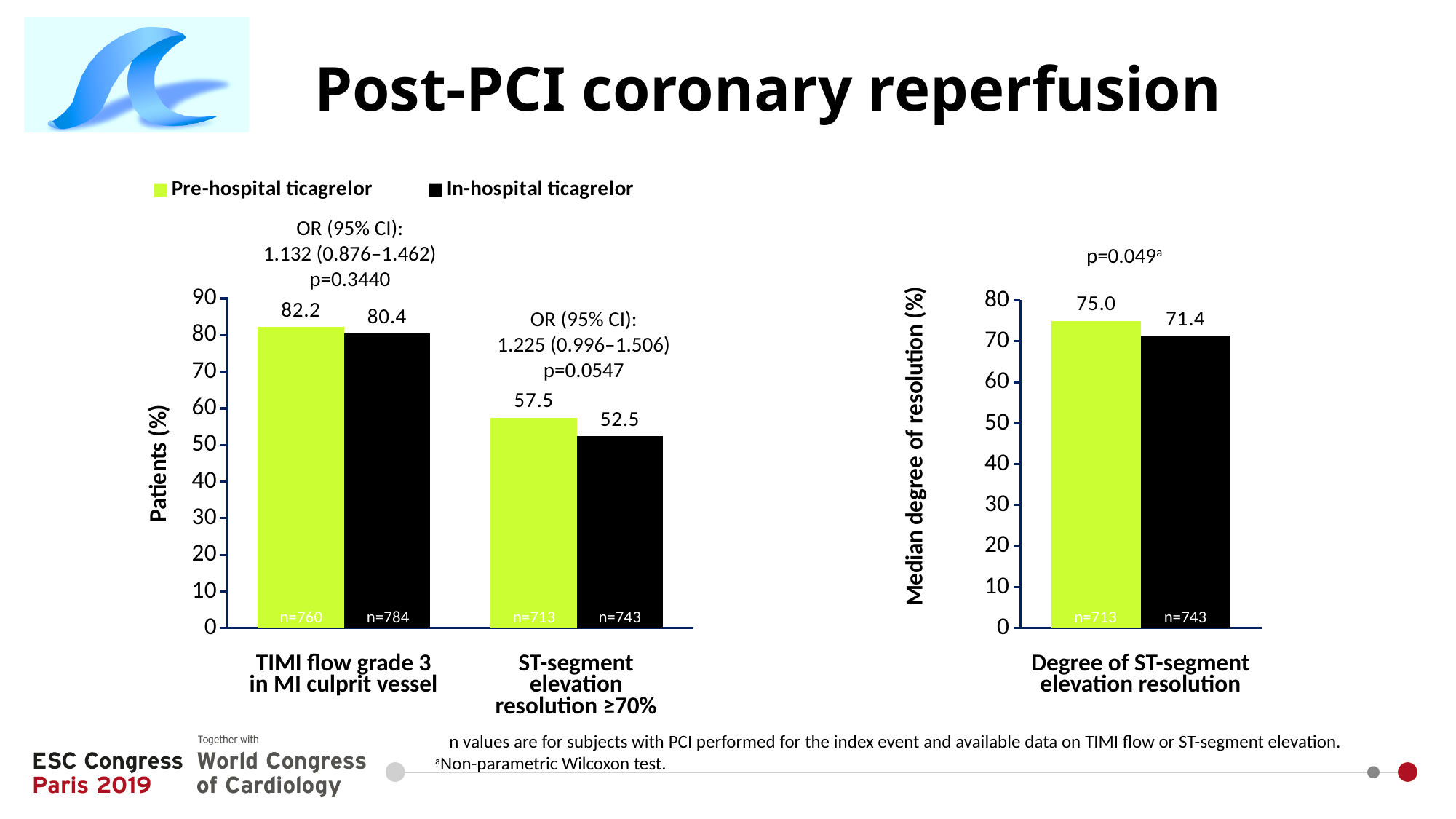
What kind of chart is the right chart (Median degree of resolution %)? Bar chart In the right chart (Median degree of resolution %), what is the value for In-hospital ticagrelor? 71.4 In the left chart (Patients %), which category has the lowest value for In-hospital ticagrelor? ST-segment elevation resolution ≥70% In the left chart (Patients %), what is the value for Pre-hospital ticagrelor for TIMI flow grade 3 in MI culprit vessel? 82.2 In the left chart (Patients %), which series has the higher value for TIMI flow grade 3 in MI culprit vessel? Pre-hospital ticagrelor What colour represents Pre-hospital ticagrelor in the charts? Green In the left chart (Patients %), what is the difference between Pre-hospital and In-hospital ticagrelor for ST-segment elevation resolution ≥70%? 5.0 How many categories are shown on the x axis of the left chart (Patients %)? 2 In the right chart (Median degree of resolution %), what is the value for Pre-hospital ticagrelor? 75.0 In the right chart (Median degree of resolution %), what is the difference between Pre-hospital and In-hospital ticagrelor? 3.6 In the left chart (Patients %), what is the value for In-hospital ticagrelor for ST-segment elevation resolution ≥70%? 52.5 How many series does the legend list? 2